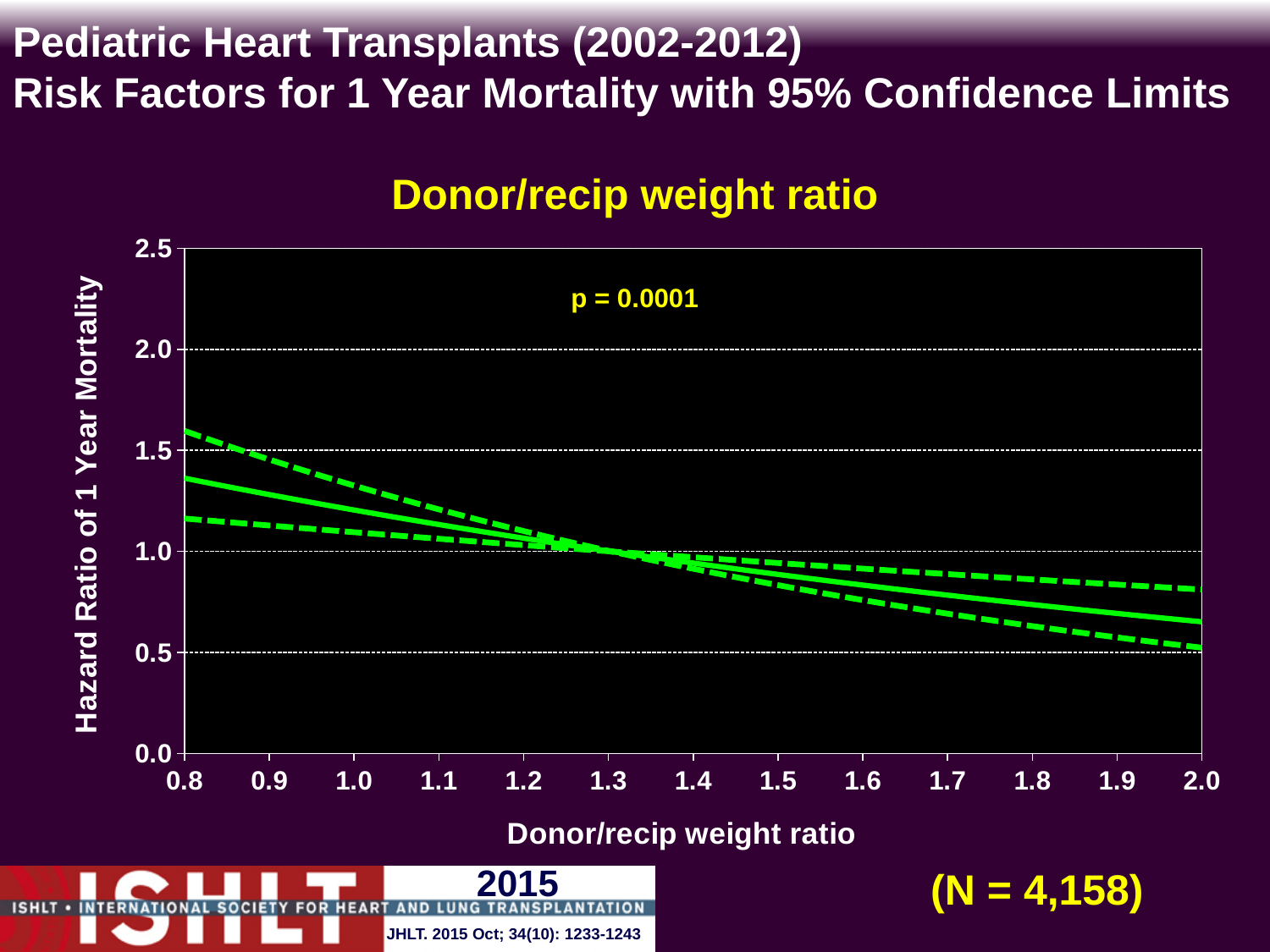
What is the label of the y axis? Hazard Ratio of 1 Year Mortality Does the solid hazard ratio line rise or fall as the donor/recip weight ratio increases from 0.8 to 2.0? fall How many tick labels are shown on the x axis of the chart? 13 What kind of chart is shown on the slide? line chart What is the p-value printed on the chart? p = 0.0001 Is the upper dashed confidence limit at a donor/recip weight ratio of 2.0 greater or less than 1.0? less How many lines are plotted on the chart? 3 Is the upper dashed confidence limit at a donor/recip weight ratio of 0.8 greater or less than 1.5? greater Is the hazard ratio (solid line) at a donor/recip weight ratio of 0.8 greater or less than 1.0? greater What is the title of the chart? Donor/recip weight ratio